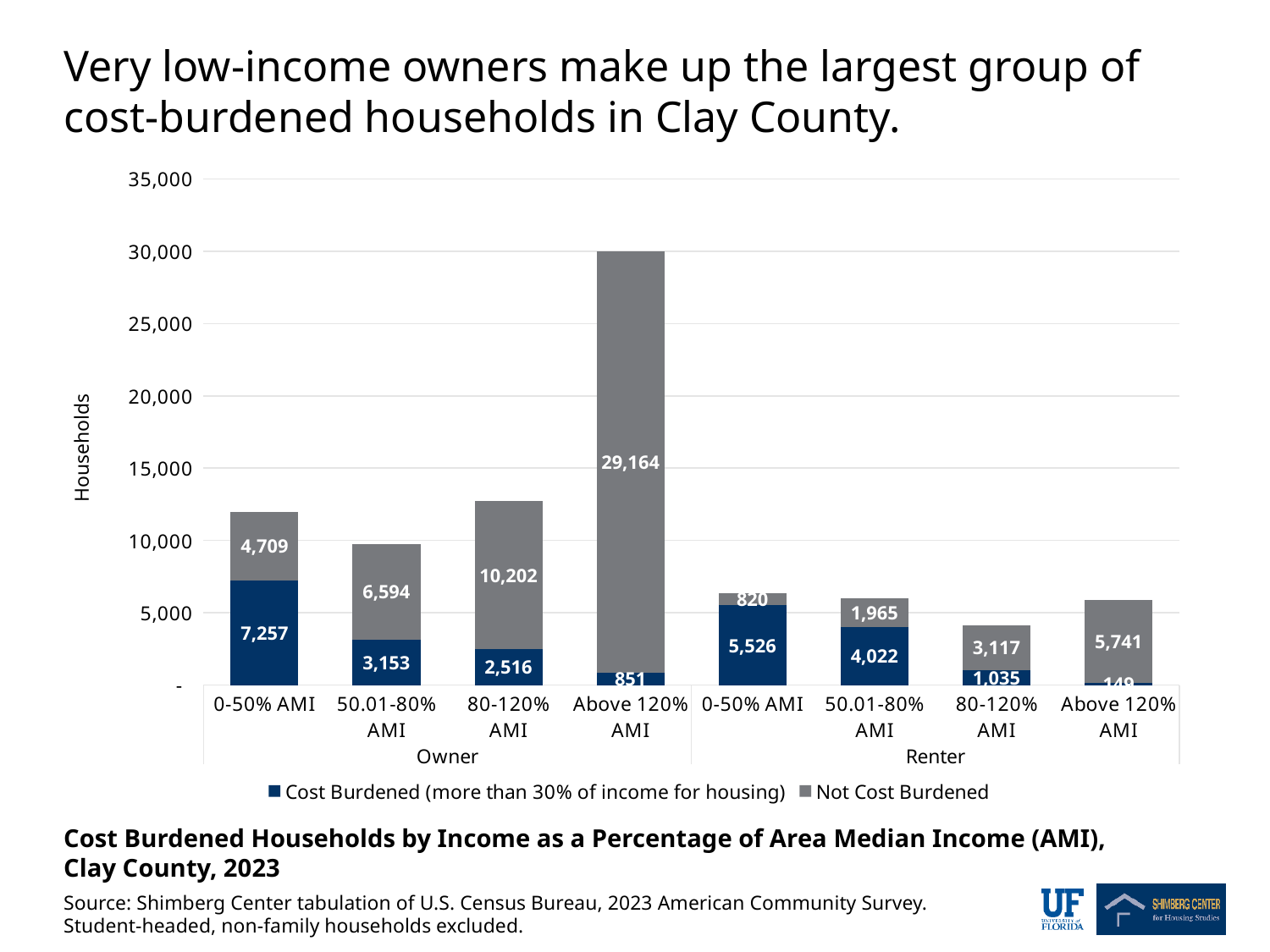
What kind of chart is shown on the slide? Stacked bar chart Which category has the largest number of cost-burdened households? Owner 0-50% AMI How many income categories are plotted across the Owner and Renter groups combined? 8 Which is larger: the number of cost-burdened owner households at 80-120% AMI or the number of cost-burdened renter households at 80-120% AMI? Owner 80-120% AMI How many series does the legend list? 2 What is the difference between cost-burdened owner households and cost-burdened renter households in the 0-50% AMI category? 1,731 How many cost-burdened owner households are in the 0-50% AMI category? 7,257 Which category has the smallest number of not-cost-burdened households? Renter 0-50% AMI How many cost-burdened renter households are in the 50.01-80% AMI category? 4,022 How many not-cost-burdened owner households are in the Above 120% AMI category? 29,164 Is the total height of the Owner Above 120% AMI bar greater or less than 25,000? greater What is the total number of households in the Owner 0-50% AMI bar? 11,966